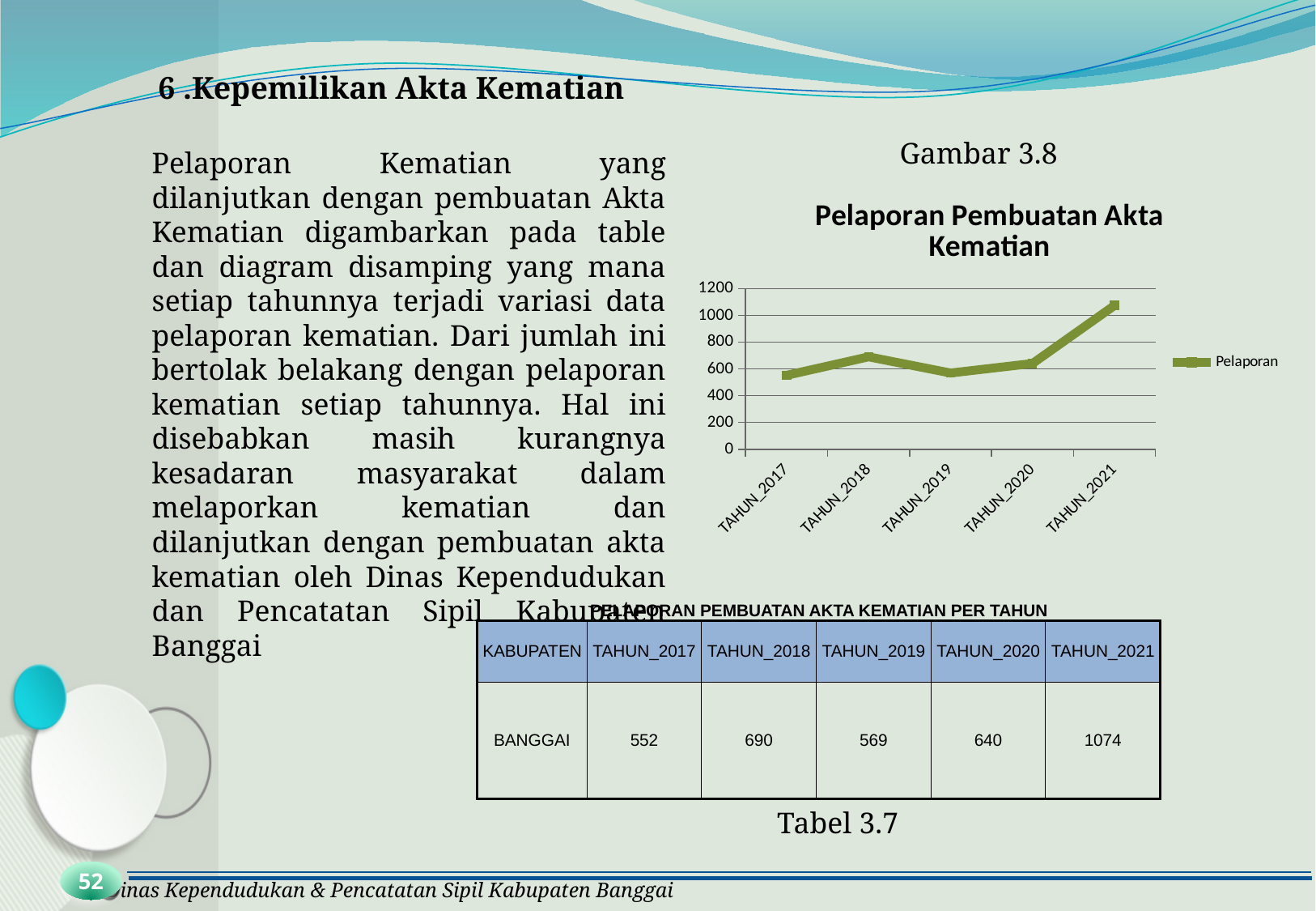
How many years are plotted along the x axis of the "Pelaporan Pembuatan Akta Kematian" chart? 5 According to the table below the chart, what is the value for TAHUN_2017 for BANGGAI? 552 Is the value for TAHUN_2019 in the "Pelaporan Pembuatan Akta Kematian" chart greater or less than 600? less In the "Pelaporan Pembuatan Akta Kematian" chart, which is larger, the value for TAHUN_2018 or TAHUN_2020? TAHUN_2018 Is the value for TAHUN_2021 in the "Pelaporan Pembuatan Akta Kematian" chart greater or less than 1000? greater Which year has the highest value in the "Pelaporan Pembuatan Akta Kematian" chart? TAHUN_2021 Which year has the lowest value in the "Pelaporan Pembuatan Akta Kematian" chart? TAHUN_2017 How many series does the legend of the "Pelaporan Pembuatan Akta Kematian" chart list? 1 According to the table below the chart, what is the value for TAHUN_2021 for BANGGAI? 1074 What is the name of the series shown in the legend of the "Pelaporan Pembuatan Akta Kematian" chart? Pelaporan Using the values in the table, what is the difference between TAHUN_2021 and TAHUN_2020 for BANGGAI? 434 What kind of chart is shown under the title "Pelaporan Pembuatan Akta Kematian"? line chart